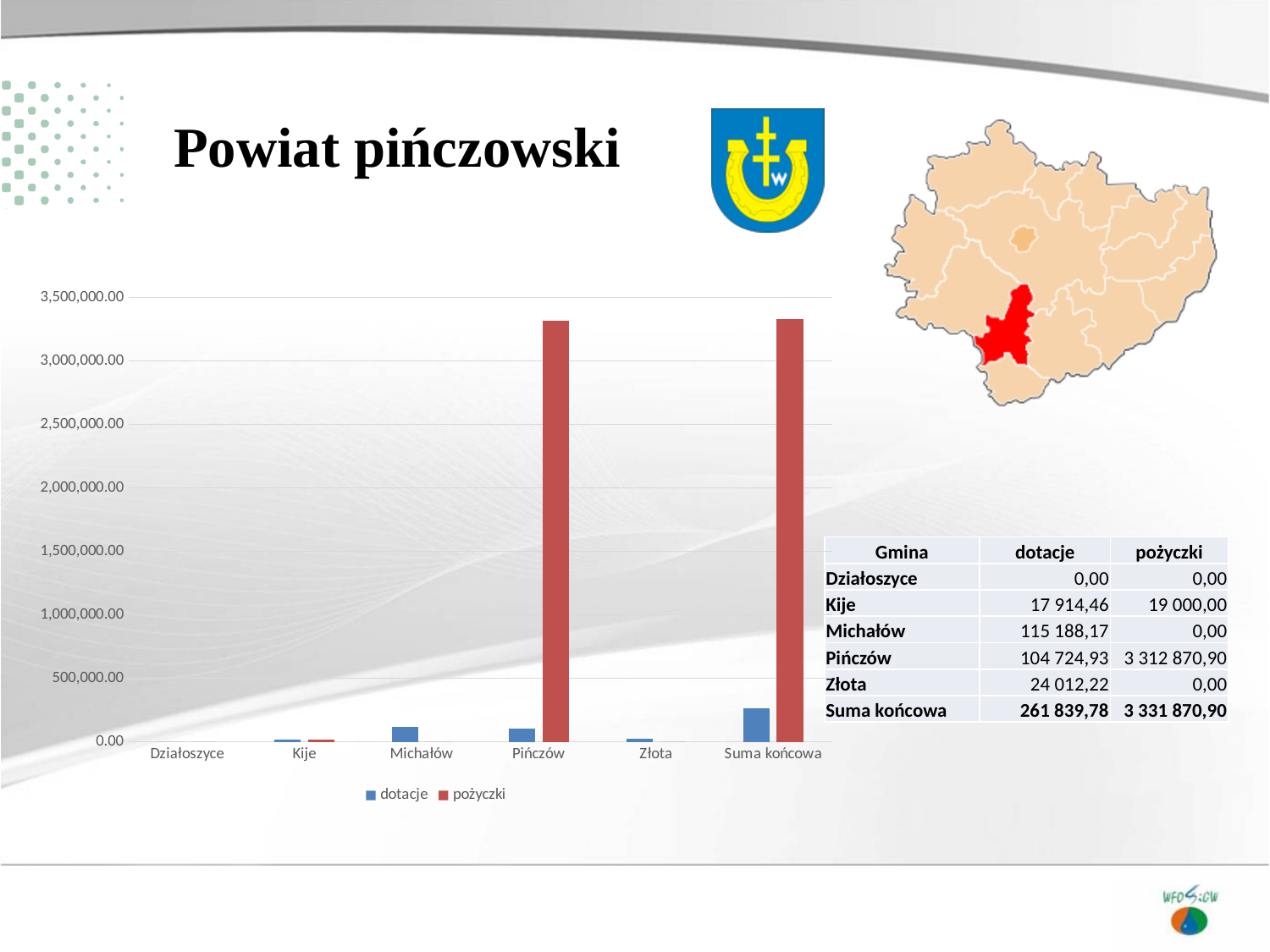
How many categories are shown on the x axis of the chart? 6 What is the difference between the pożyczki values for Pińczów and Kije, using the table values? 3 293 870,90 Which colour represents the pożyczki series in the chart? red Which category has the highest pożyczki value among the individual gminas (excluding Suma końcowa)? Pińczów Is the pożyczki value for Pińczów greater or less than 3,000,000.00? greater Which is larger for Kije: dotacje or pożyczki? pożyczki How many series does the chart legend list? 2 What kind of chart is shown on the slide? bar chart According to the table on the slide, what is the dotacje value for Suma końcowa? 261 839,78 Is the dotacje value for Suma końcowa greater or less than 500,000.00? less According to the table on the slide, what is the dotacje value for Michałów? 115 188,17 According to the table on the slide, what is the pożyczki value for Pińczów? 3 312 870,90